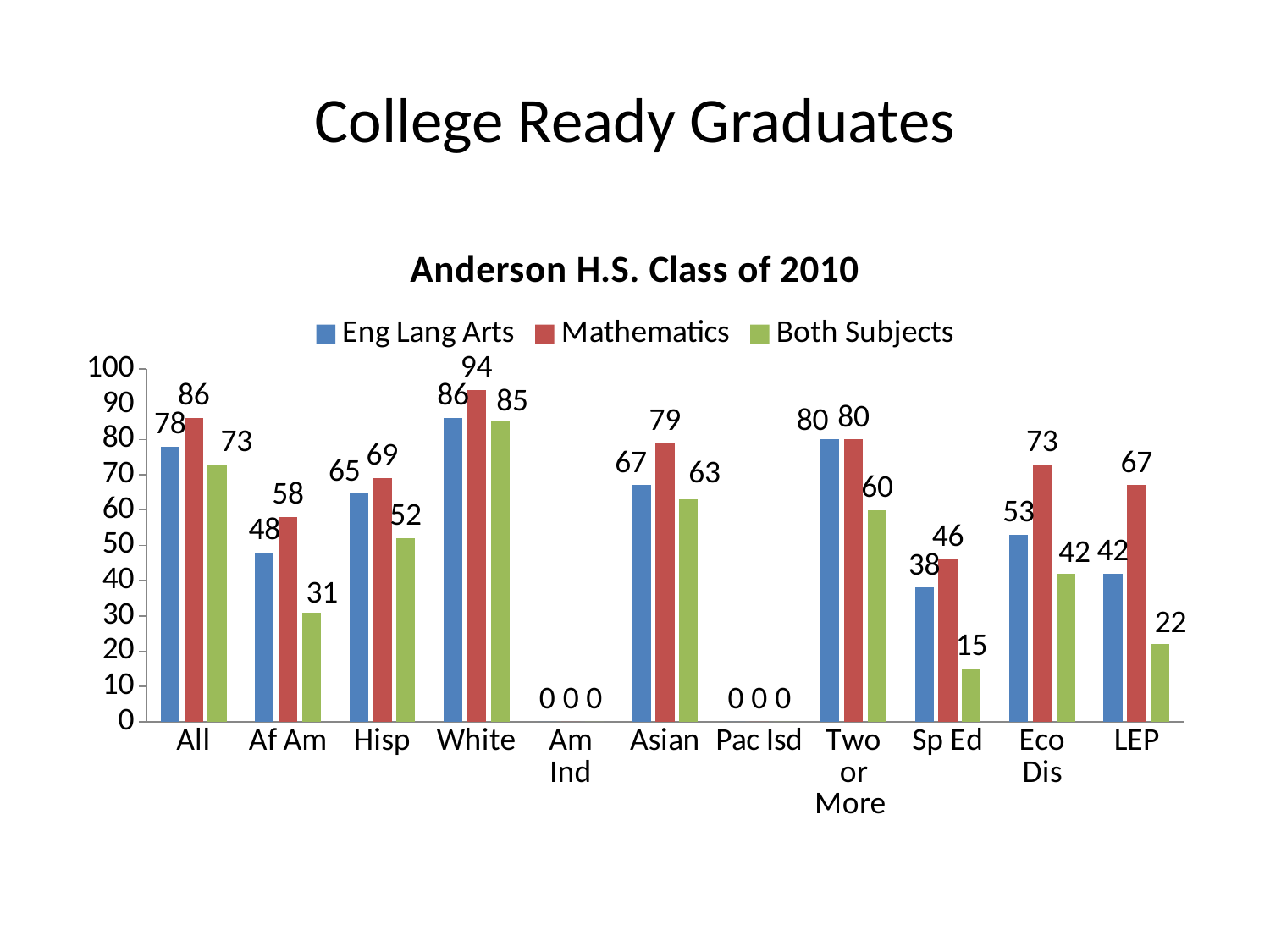
Which category has the highest Mathematics value? White Which colour represents the Both Subjects series? Green How many series does the legend list? 3 Among categories with non-zero values, which has the lowest Both Subjects value? Sp Ed What is the Mathematics value for White? 94 Which is larger for Af Am: the Eng Lang Arts value or the Mathematics value? Mathematics What is the Both Subjects value for Sp Ed? 15 What is the title of the chart? Anderson H.S. Class of 2010 What is the Eng Lang Arts value for Eco Dis? 53 What kind of chart is shown? Bar chart How many categories are shown on the x axis? 11 What is the difference between the Mathematics and Eng Lang Arts values for LEP? 25